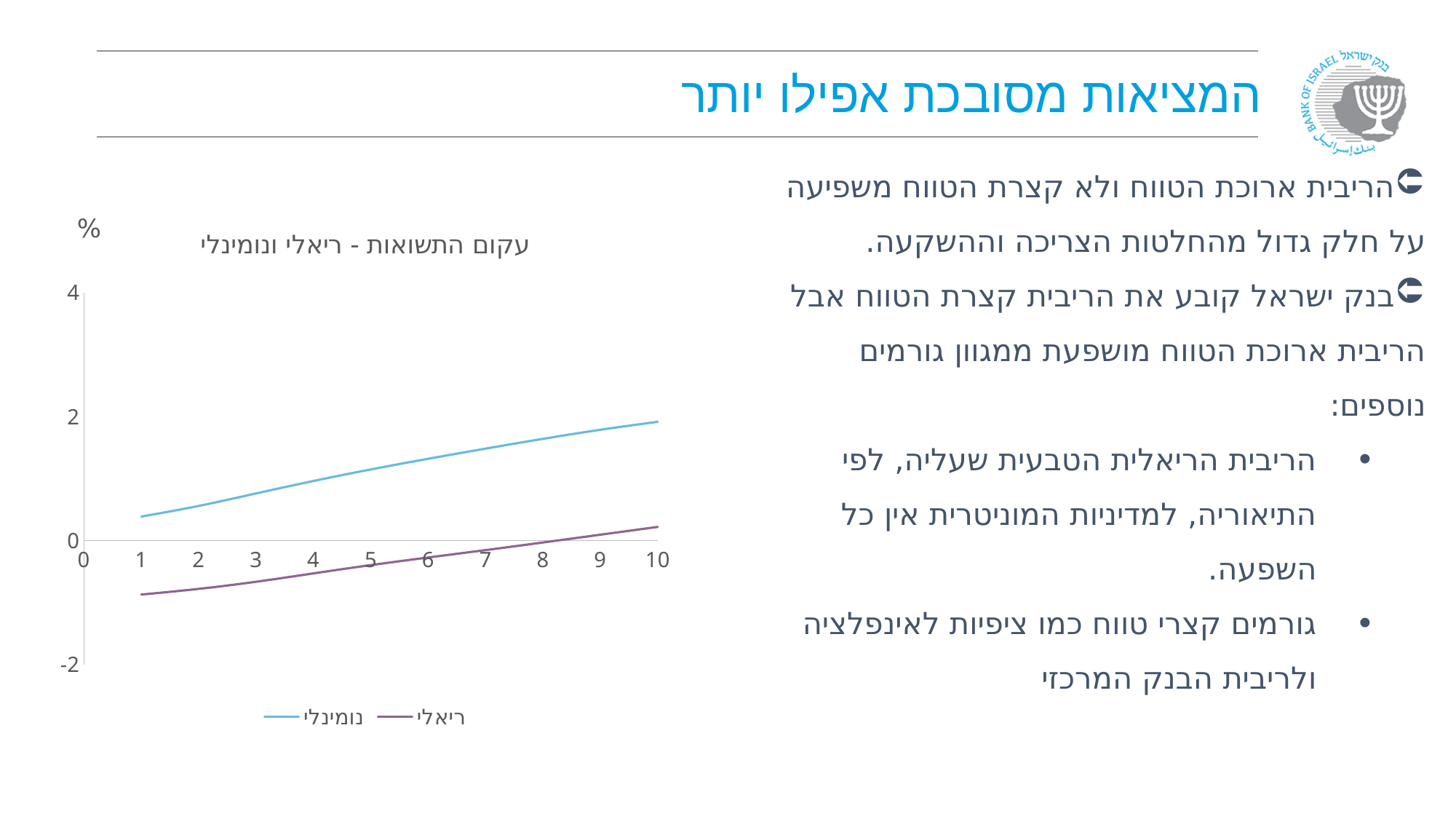
Is the value of the ריאלי series at x = 3 greater or less than 0? less What kind of chart is shown on the slide? line chart At x = 1, which series has the lower value, נומינלי or ריאלי? ריאלי What is the title of the chart? עקום התשואות - ריאלי ונומינלי How many series does the chart legend list? 2 Is the value of the נומינלי series at x = 1 greater or less than 2? less At x = 10, which series has the higher value, נומינלי or ריאלי? נומינלי Which series is drawn in blue in the chart? נומינלי Does the ריאלי line rise or fall as the x axis goes from 1 to 10? rise Does the נומינלי line rise or fall as the x axis goes from 1 to 10? rise Is the value of the ריאלי series at x = 1 greater or less than 0? less